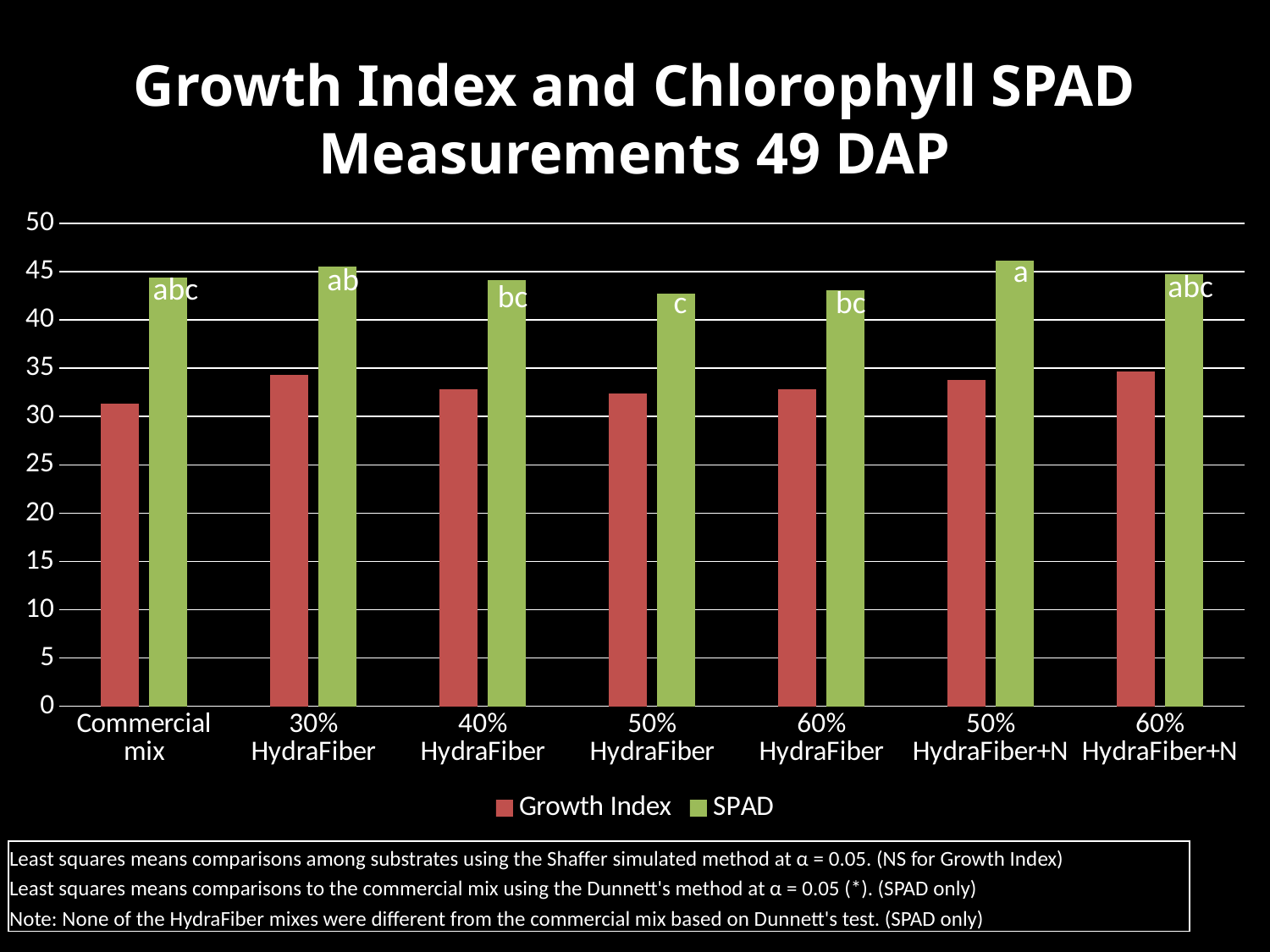
Which is larger, the SPAD value for 50% HydraFiber+N or the SPAD value for 50% HydraFiber? 50% HydraFiber+N Which category has the highest SPAD value? 50% HydraFiber+N Is the SPAD value for 50% HydraFiber+N greater or less than 45? greater For 40% HydraFiber, which is larger, the Growth Index or the SPAD value? SPAD Which category has the lowest Growth Index value? Commercial mix How many substrate categories are shown on the x axis? 7 What kind of chart is shown on the slide? bar chart Is the Growth Index value for 30% HydraFiber greater or less than 30? greater How many series does the legend list? 2 Is the Growth Index value for Commercial mix greater or less than 35? less What letter label is printed on the SPAD bar for 50% HydraFiber+N? a